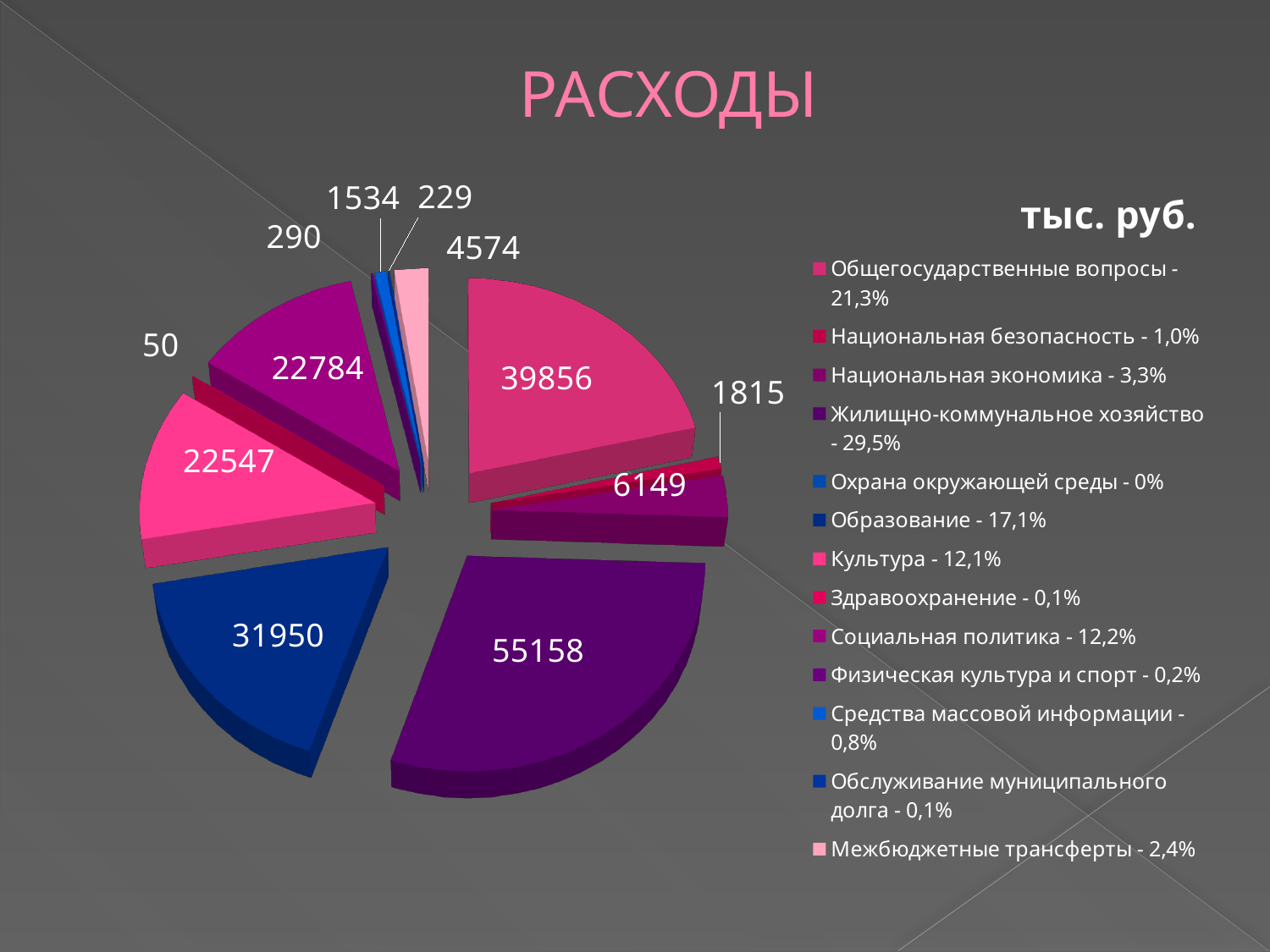
What is the value for Образование? 31950 What is the value for Жилищно-коммунальное хозяйство? 55158 What is the value for Общегосударственные вопросы? 39856 What unit is indicated for the values in the chart? тыс. руб. Which category has the largest slice of the pie? Жилищно-коммунальное хозяйство What share of the pie does Образование represent, according to the legend? 17,1% Which is larger, the value for Образование or the value for Общегосударственные вопросы? Общегосударственные вопросы How many categories does the legend list? 13 What is the difference between the values for Жилищно-коммунальное хозяйство and Общегосударственные вопросы? 15302 What is the value for Межбюджетные трансферты? 4574 What is the title of the chart on the slide? тыс. руб. What kind of chart is shown on the slide? pie chart